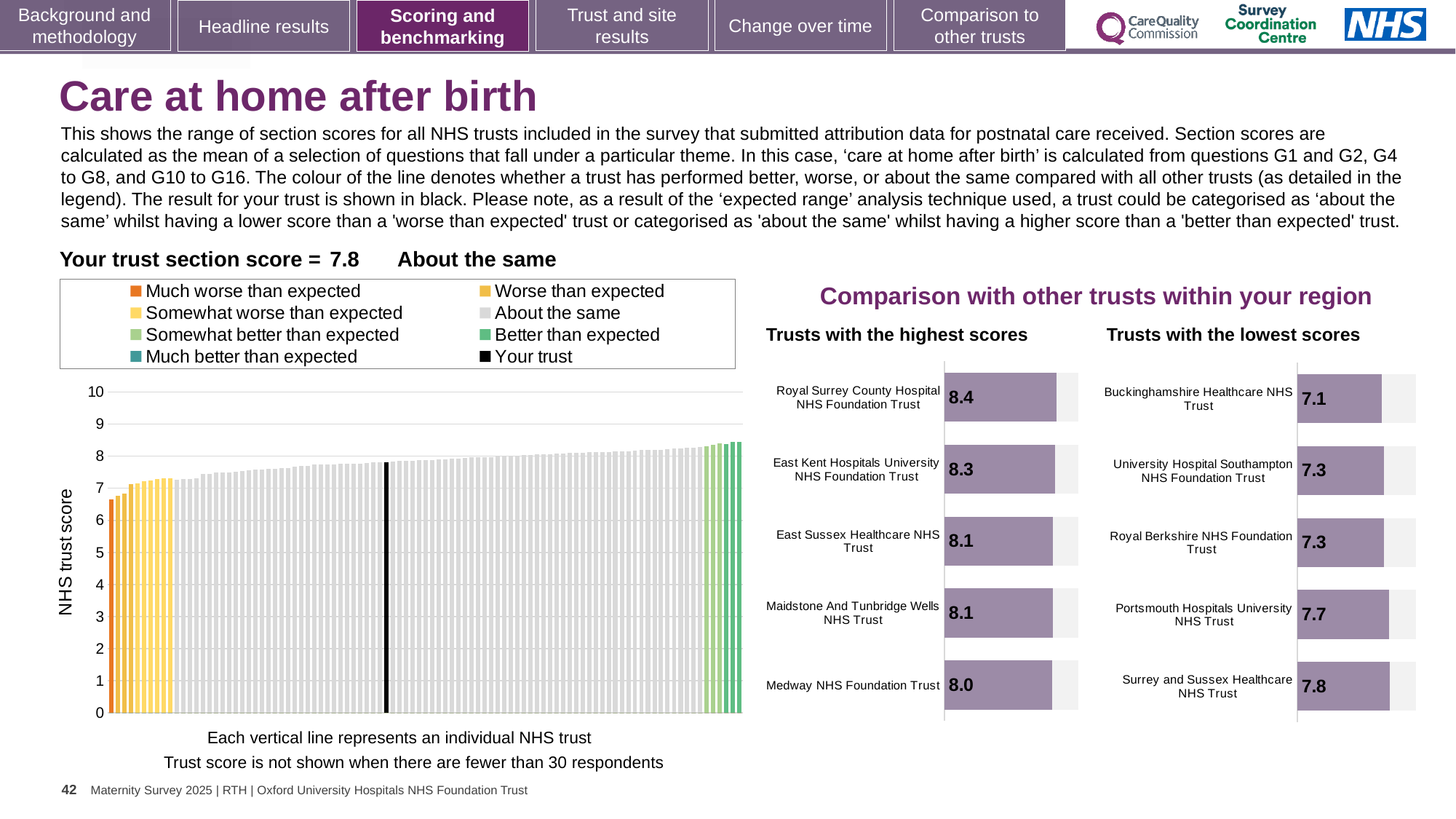
Which is larger: the score for East Kent Hospitals University NHS Foundation Trust in the 'Trusts with the highest scores' chart or the score for Portsmouth Hospitals University NHS Trust in the 'Trusts with the lowest scores' chart? East Kent Hospitals University NHS Foundation Trust In the 'Trusts with the lowest scores' chart, how many trusts are shown? 5 In the large 'NHS trust score' chart on the left, what kind of chart is it? Bar chart In the 'Trusts with the lowest scores' chart, what is the score for Buckinghamshire Healthcare NHS Trust? 7.1 How many entries does the legend above the large 'NHS trust score' chart list? 8 In the 'Trusts with the highest scores' chart, what is the difference between the scores of Royal Surrey County Hospital NHS Foundation Trust and Medway NHS Foundation Trust? 0.4 In the 'Trusts with the highest scores' chart, which trust has the lowest score? Medway NHS Foundation Trust In the 'Trusts with the highest scores' chart, what is the score for Royal Surrey County Hospital NHS Foundation Trust? 8.4 In the large 'NHS trust score' chart on the left, is the value for the black 'Your trust' bar greater or less than 7? greater In the large 'NHS trust score' chart on the left, do the values rise or fall from left to right? Rise In the 'Trusts with the lowest scores' chart, what is the difference between the scores of Surrey and Sussex Healthcare NHS Trust and Buckinghamshire Healthcare NHS Trust? 0.7 In the 'Trusts with the lowest scores' chart, which trust has the highest score? Surrey and Sussex Healthcare NHS Trust